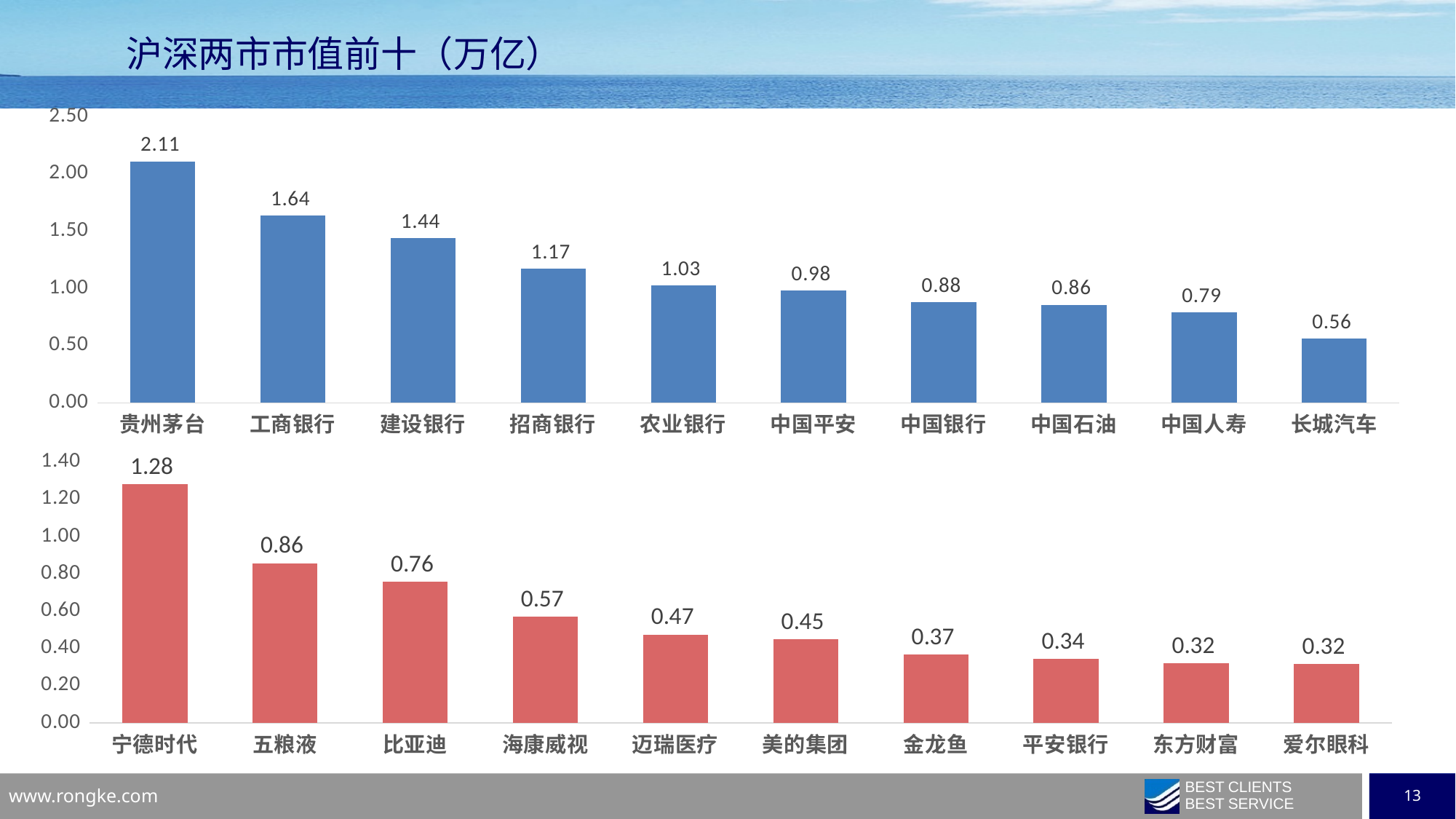
In the bottom chart, what is the difference between the values for 宁德时代 and 五粮液? 0.42 What is the title of the slide? 沪深两市市值前十（万亿） In the top chart, which is larger, the value for 招商银行 or the value for 农业银行? 招商银行 What kind of chart is the top chart? bar chart In the top chart, what is the value for 贵州茅台? 2.11 In the top chart, what is the difference between the values for 工商银行 and 建设银行? 0.20 In the top chart, which category has the lowest value? 长城汽车 In the top chart, do the values rise or fall from left to right along the x axis? fall How many categories are shown in the bottom chart? 10 In the bottom chart, which category has the highest value? 宁德时代 In the bottom chart, is the value for 海康威视 greater or less than 0.40? greater In the bottom chart, what is the value for 比亚迪? 0.76